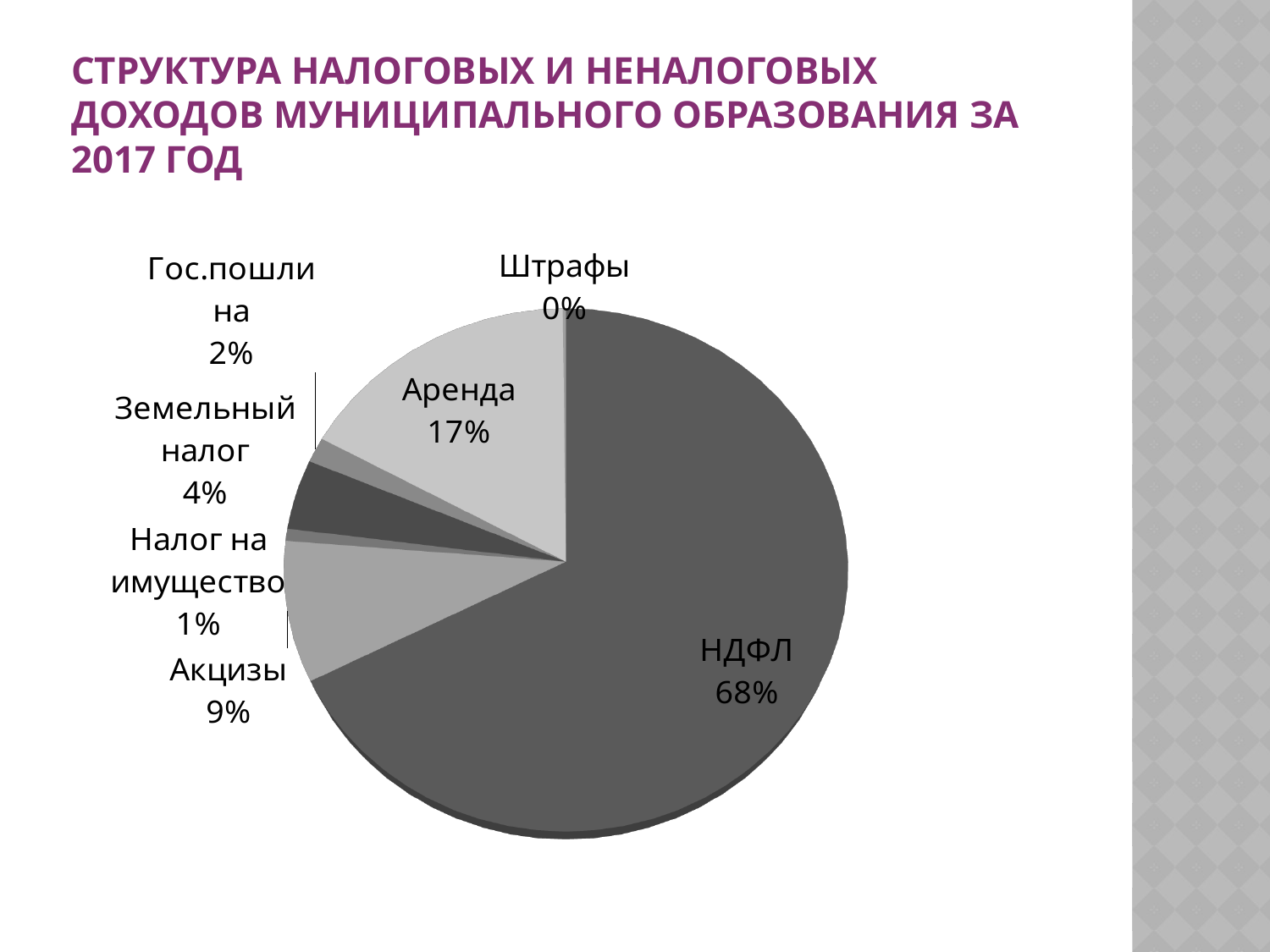
What share of the pie does Земельный налог have? 4% Which has a larger share, Акцизы or Земельный налог? Акцизы Which category has the smallest share of the pie? Штрафы What kind of chart is shown on the slide? pie chart Which category has the largest share of the pie? НДФЛ What is the difference in percentage points between the shares of НДФЛ and Аренда? 51 What share of the pie does Акцизы have? 9% What share of the pie does Налог на имущество have? 1% How many slices does the pie chart have? 7